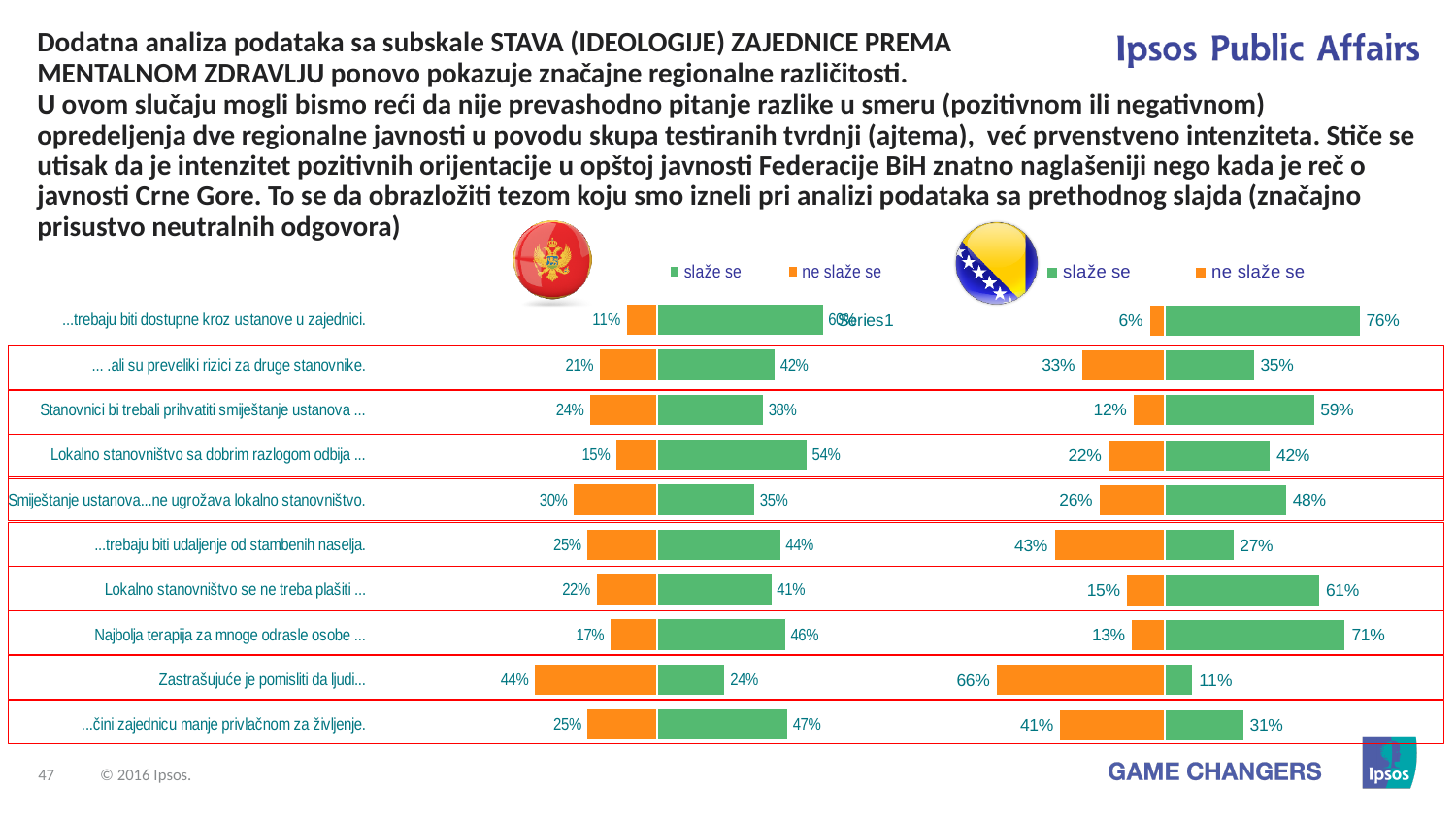
In the right chart, what is the 'slaže se' value for 'Najbolja terapija za mnoge odrasle osobe ...'? 71% What type of chart is the left chart? bar chart In the right chart, which category has the highest 'slaže se' value? ...trebaju biti dostupne kroz ustanove u zajednici. How many categories are shown in the left chart? 10 In the left chart, which category has the highest 'ne slaže se' value? Zastrašujuće je pomisliti da ljudi... In the right chart, what is the difference between the 'slaže se' and 'ne slaže se' values for 'Zastrašujuće je pomisliti da ljudi...'? 55% In the right chart, what is the 'ne slaže se' value for '...trebaju biti udaljenje od stambenih naselja.'? 43% How many series does the legend of the right chart list? 2 In the left chart, what is the 'slaže se' value for 'Lokalno stanovništvo sa dobrim razlogom odbija ...'? 54% In the left chart, what is the 'ne slaže se' value for 'Zastrašujuće je pomisliti da ljudi...'? 44% In the right chart, which category has the lowest 'slaže se' value? Zastrašujuće je pomisliti da ljudi... In the left chart, which is larger for 'Smiještanje ustanova...ne ugrožava lokalno stanovništvo.': 'slaže se' or 'ne slaže se'? slaže se